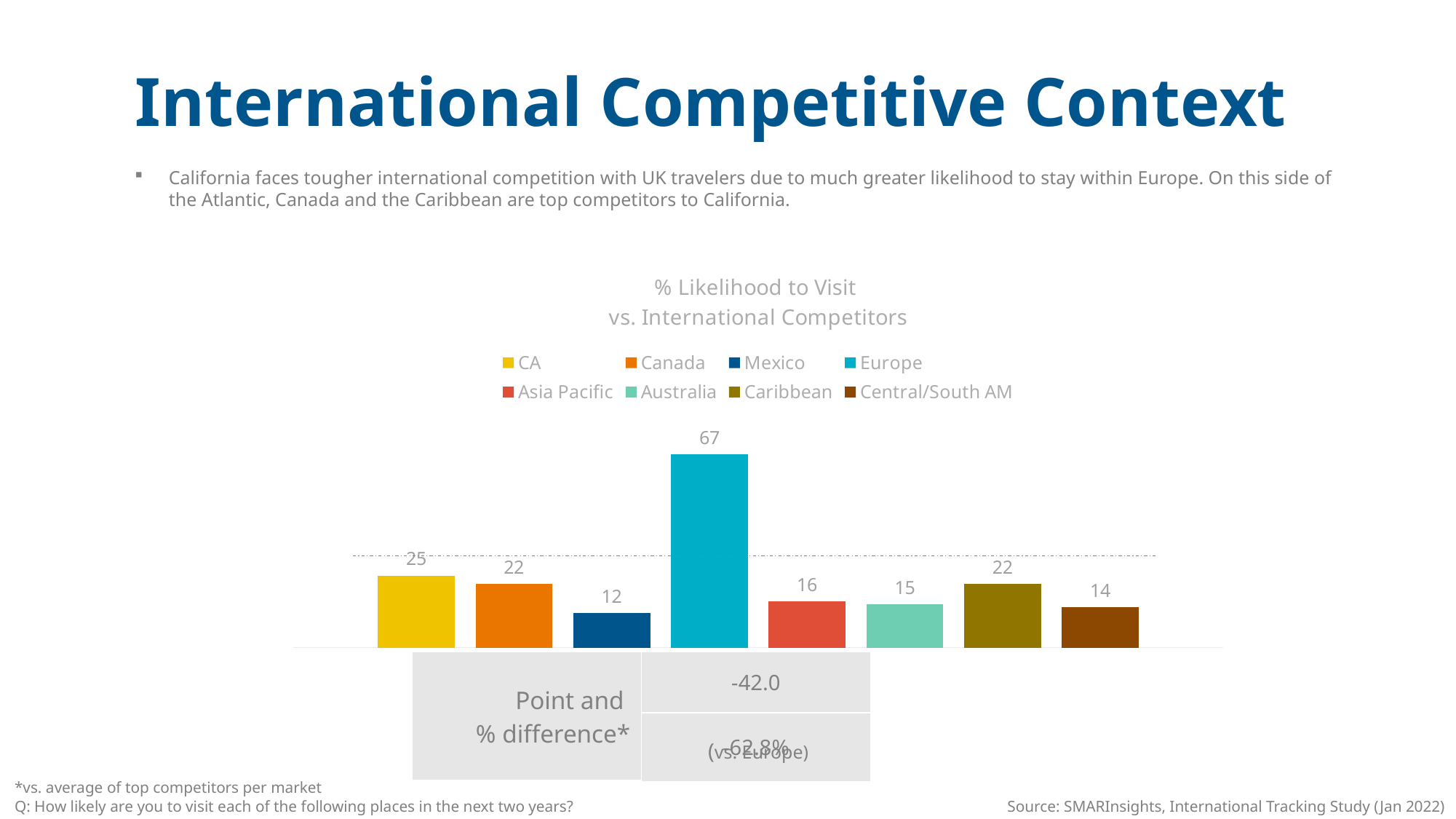
What type of chart is shown on the slide? Bar chart What is the difference between the values for Canada and Mexico? 10 How many destinations are plotted in the chart? 8 What is the title of the chart? % Likelihood to Visit vs. International Competitors What is the difference between the values for Europe and CA? 42 Which destination has the lowest % likelihood to visit? Mexico What is the value for Mexico in the % Likelihood to Visit chart? 12 What is the value for CA in the % Likelihood to Visit chart? 25 What is the value for Europe in the % Likelihood to Visit chart? 67 Which destination has the highest % likelihood to visit? Europe Which has a higher value, Asia Pacific or Canada? Canada What is the value for Central/South AM in the % Likelihood to Visit chart? 14